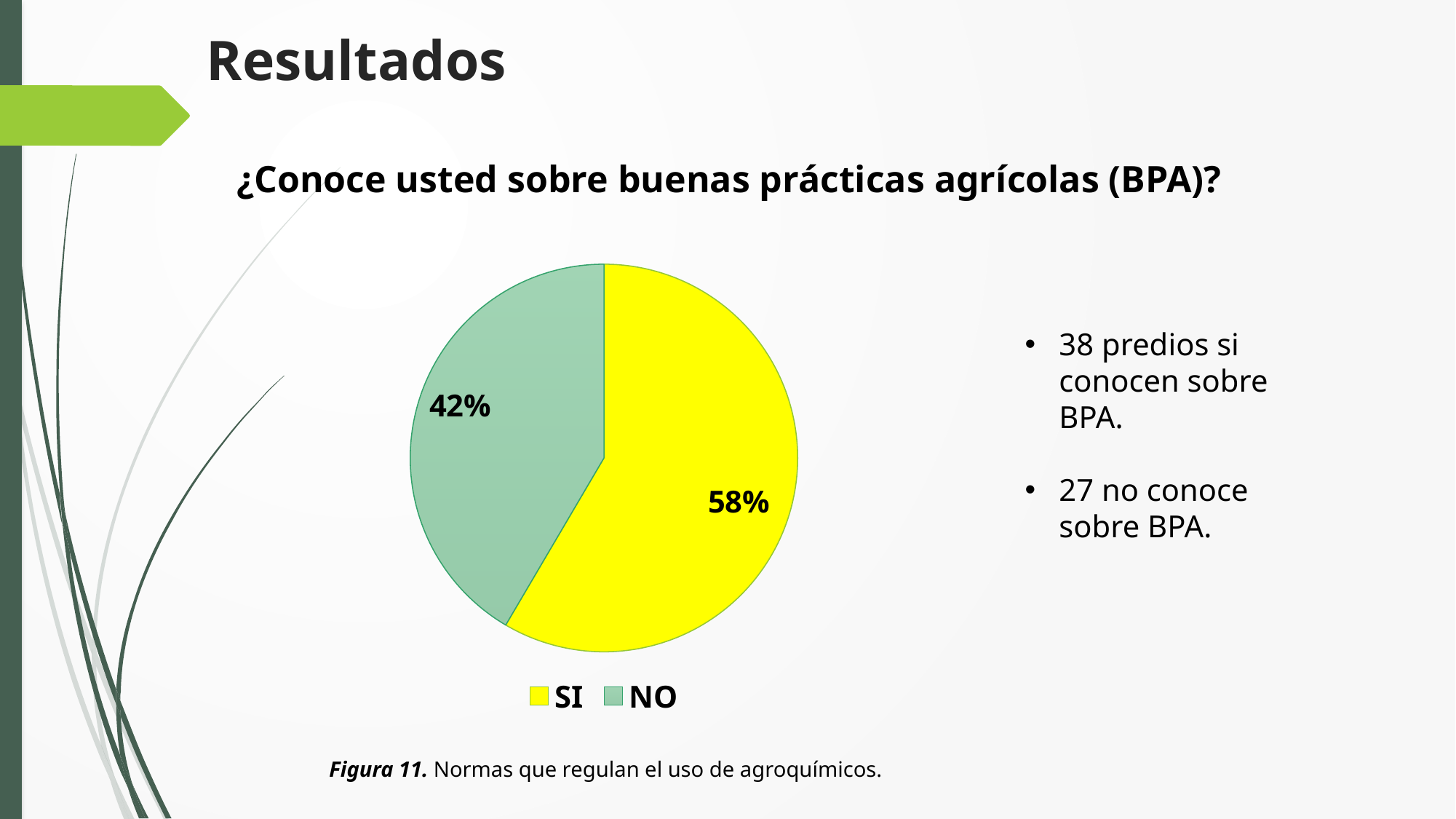
Is the share for NO greater or less than 50%? less What percentage of the pie corresponds to NO? 42% Which category has the smallest share of the pie? NO What percentage of the pie corresponds to SI? 58% How many slices does the pie chart have? 2 Which slice is larger, SI or NO? SI What question is the pie chart answering, according to the heading above it? ¿Conoce usted sobre buenas prácticas agrícolas (BPA)? What kind of chart is shown on the slide? pie chart What colour is the SI slice? yellow What is the difference in percentage points between the SI and NO slices? 16% How many entries does the legend list? 2 Which category has the largest share of the pie? SI